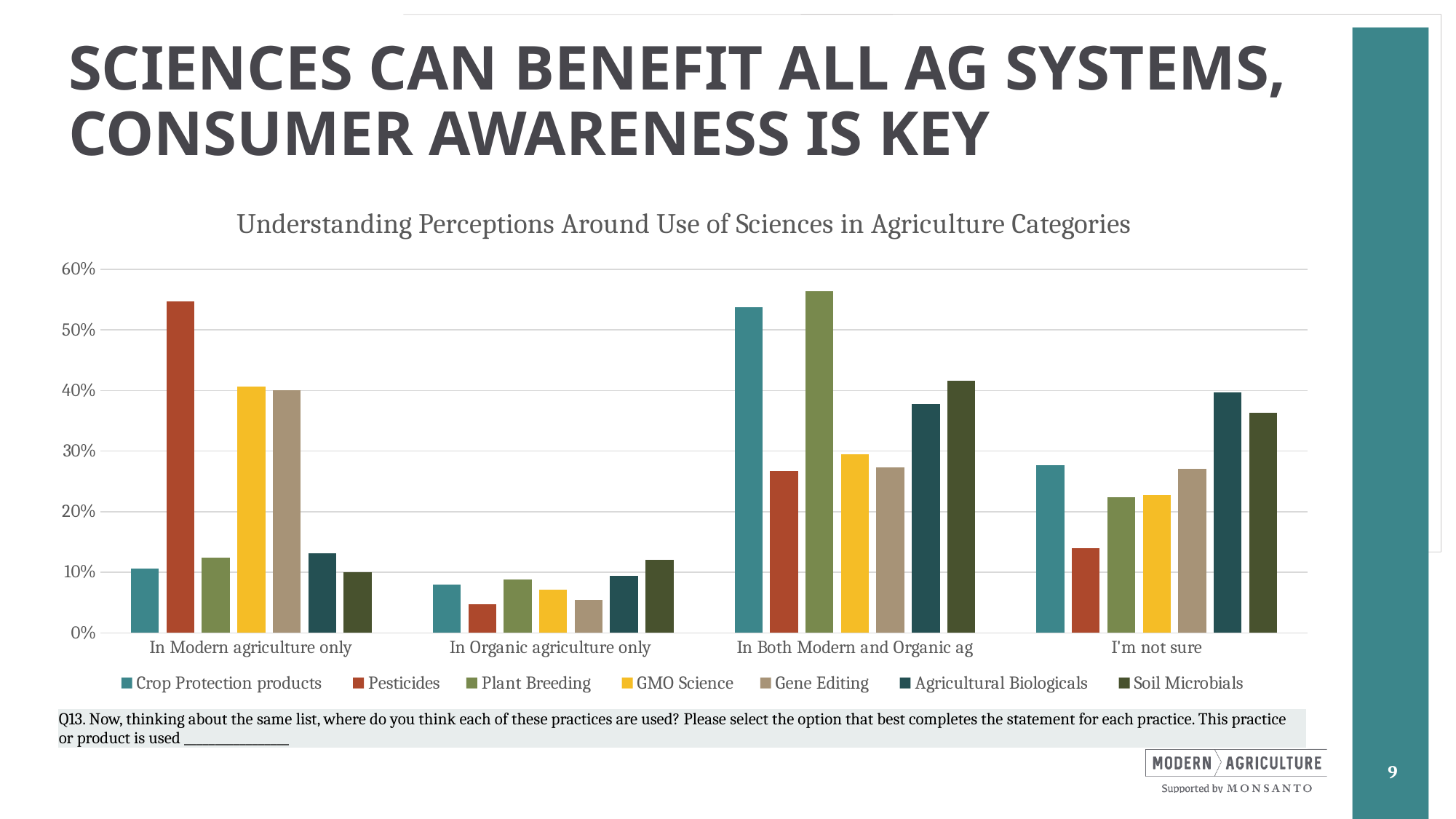
In the 'In Both Modern and Organic ag' category, which series has the highest value? Plant Breeding Is the value for Crop Protection products in 'In Both Modern and Organic ag' greater or less than 50%? greater In the 'In Modern agriculture only' category, which series has the highest value? Pesticides What is the title of the chart? Understanding Perceptions Around Use of Sciences in Agriculture Categories Is the value for Pesticides in 'In Modern agriculture only' greater or less than 50%? greater How many categories are shown on the x axis? 4 Is the value for Pesticides in 'I'm not sure' greater or less than 20%? less How many series does the legend list? 7 In the 'In Organic agriculture only' category, which series has the highest value? Soil Microbials What kind of chart is shown on the slide? Bar chart Which is larger: the Pesticides value for 'In Modern agriculture only' or the Pesticides value for 'In Both Modern and Organic ag'? In Modern agriculture only